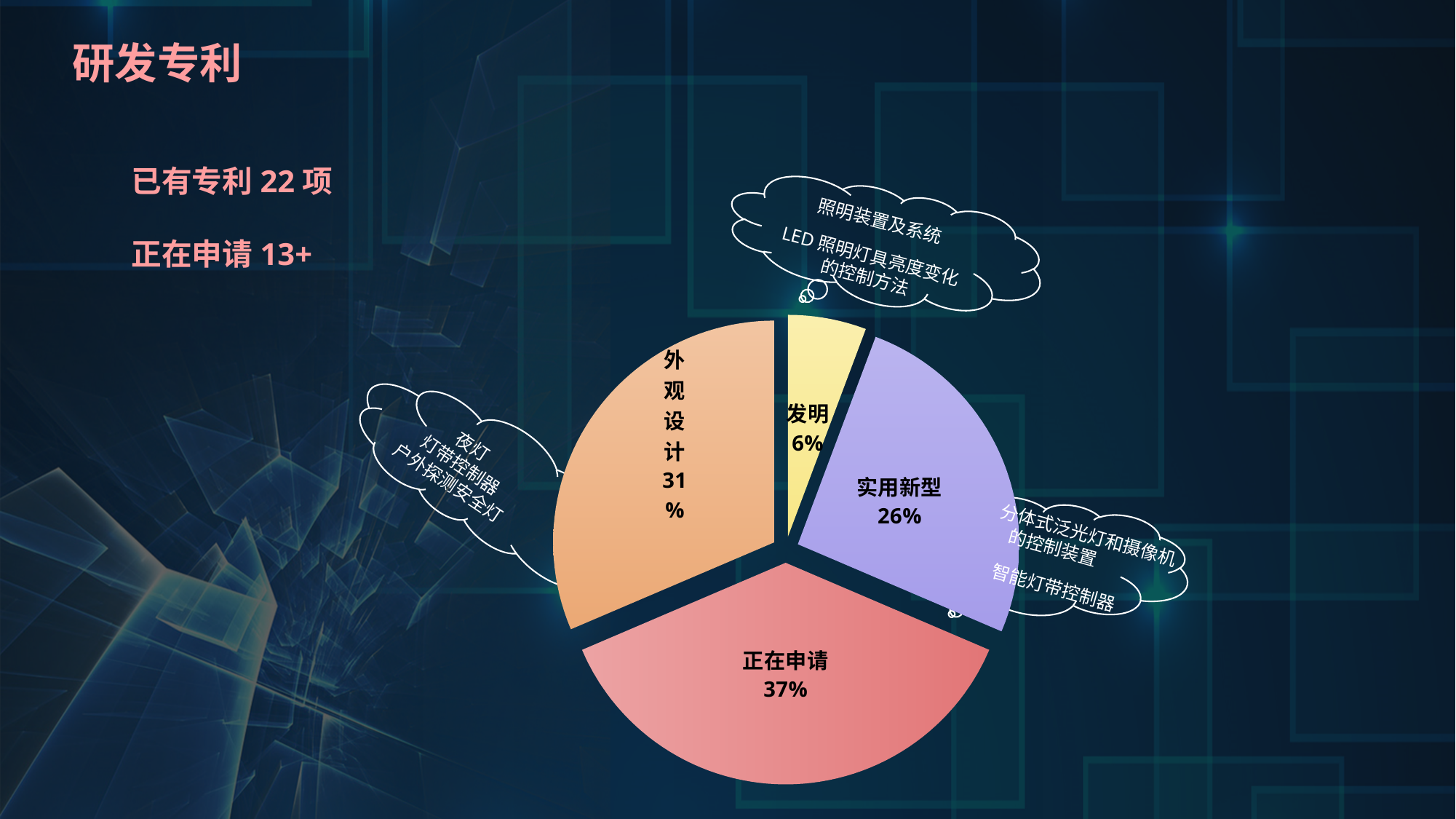
How many slices does the pie chart have? 4 Which slice of the pie is the largest? 正在申请 What colour is the 正在申请 slice? red/pink What percentage does the 正在申请 slice show? 37% What percentage does the 发明 slice show? 6% What is the difference in percentage points between 外观设计 and 发明? 25 What kind of chart is shown on the slide? pie chart What percentage does the 外观设计 slice show? 31% Which is larger, 外观设计 or 实用新型? 外观设计 What percentage does the 实用新型 slice show? 26% What is the difference in percentage points between 正在申请 and 实用新型? 11 Which slice of the pie is the smallest? 发明